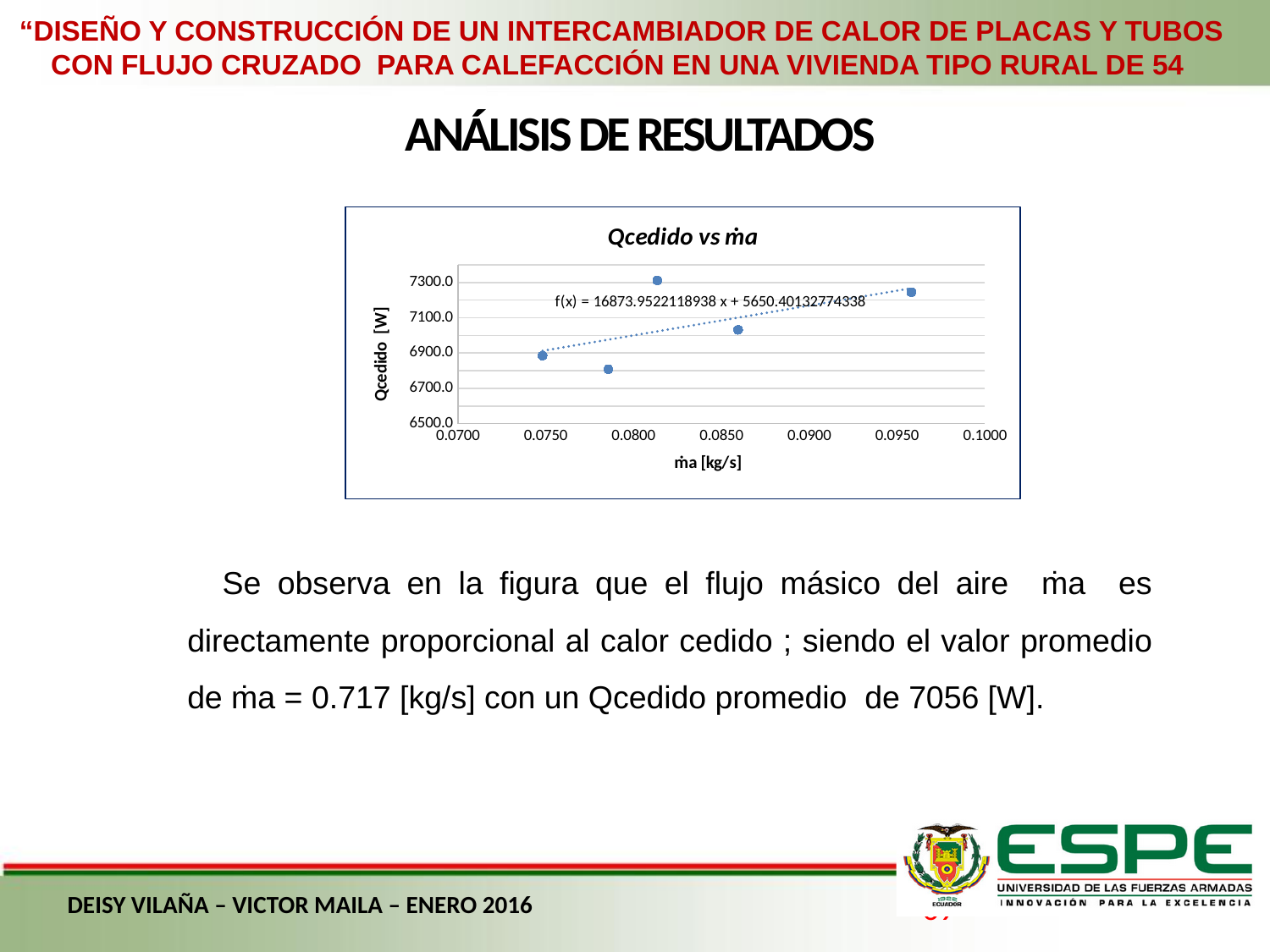
What is the title of the chart? Qcedido vs ṁa Is the Qcedido value of the lowest plotted point greater or less than 6900.0? less What kind of chart is shown on the slide? Scatter chart How many data points are plotted in the chart? 5 What is the trendline equation displayed on the chart? f(x) = 16873.9522118938 x + 5650.40132774338 What is the label of the vertical axis of the chart? Qcedido [W] What is the maximum value shown on the vertical axis of the chart? 7300.0 Is the Qcedido value of the point with the largest ṁa (near 0.0950) greater or less than 7100.0? greater Does the trendline in the chart rise or fall as ṁa increases? Rises Is the Qcedido value of the point with the smallest ṁa (near 0.0750) greater or less than 6700.0? greater